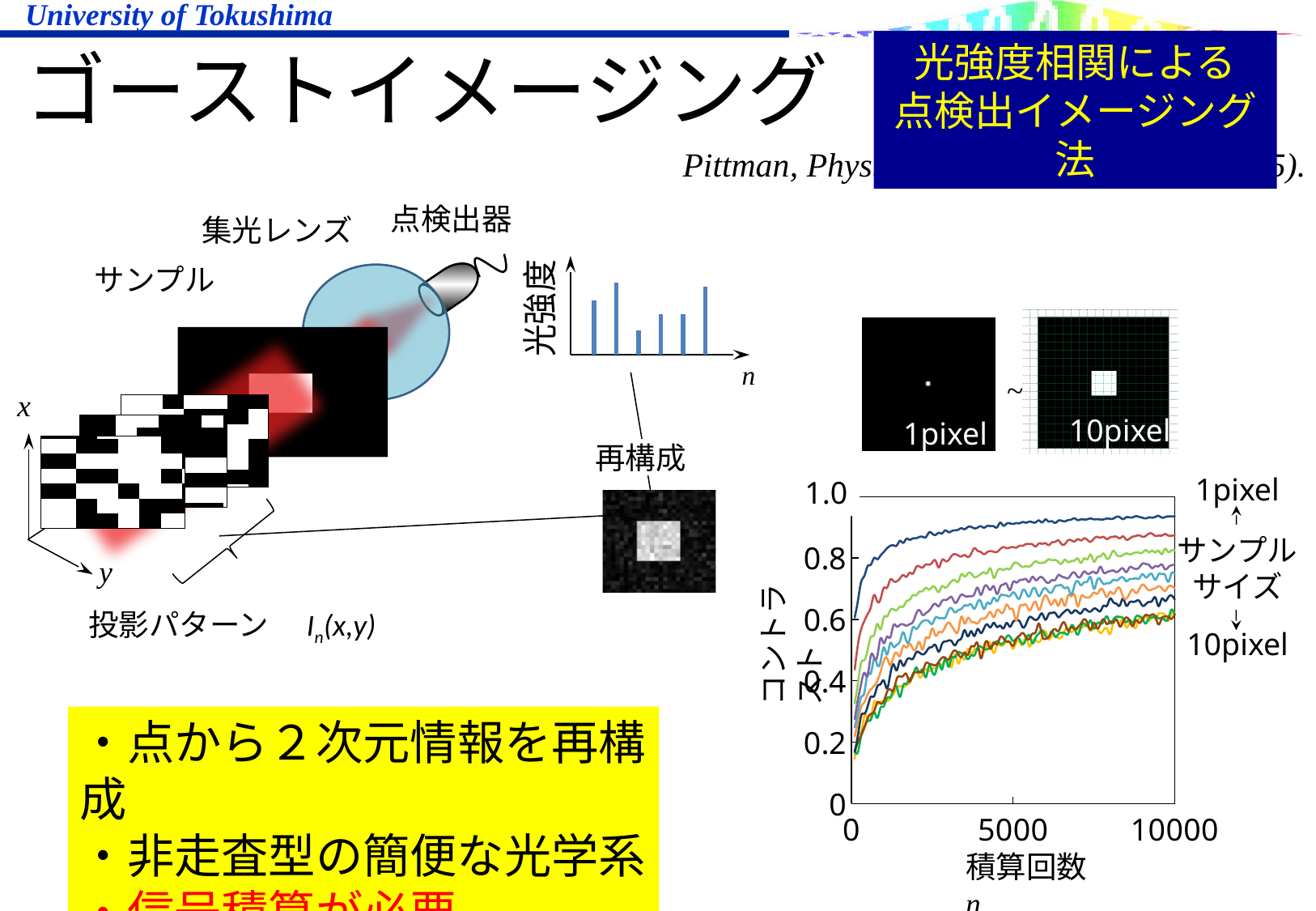
In the コントラスト vs 積算回数 chart, which curve has the larger contrast at n = 5000, the 1pixel curve or the 10pixel curve? 1pixel In the コントラスト vs 積算回数 chart, is the contrast of the 1pixel curve at n = 10000 greater or less than 0.8? greater What kind of chart is the コントラスト vs 積算回数 chart at the bottom right of the slide? line chart What is the label of the y axis of the chart at the bottom right of the slide? コントラスト In the コントラスト vs 積算回数 chart, which sample size gives the highest contrast curve? 1pixel In the コントラスト vs 積算回数 chart, does the contrast rise or fall as the accumulation count n increases? rise In the コントラスト vs 積算回数 chart, is the contrast of the 10pixel curve at n = 10000 greater or less than 0.8? less In the コントラスト vs 積算回数 chart, is the contrast of the 10pixel curve at n = 10000 greater or less than 0.4? greater How many sample-size curves are plotted in the コントラスト vs 積算回数 chart? 10 What kind of chart is the small 光強度 vs n diagram in the middle of the slide? bar chart What is the largest tick value shown on the x axis of the コントラスト vs 積算回数 chart? 10000 In the コントラスト vs 積算回数 chart, which sample size gives the lowest contrast curve? 10pixel